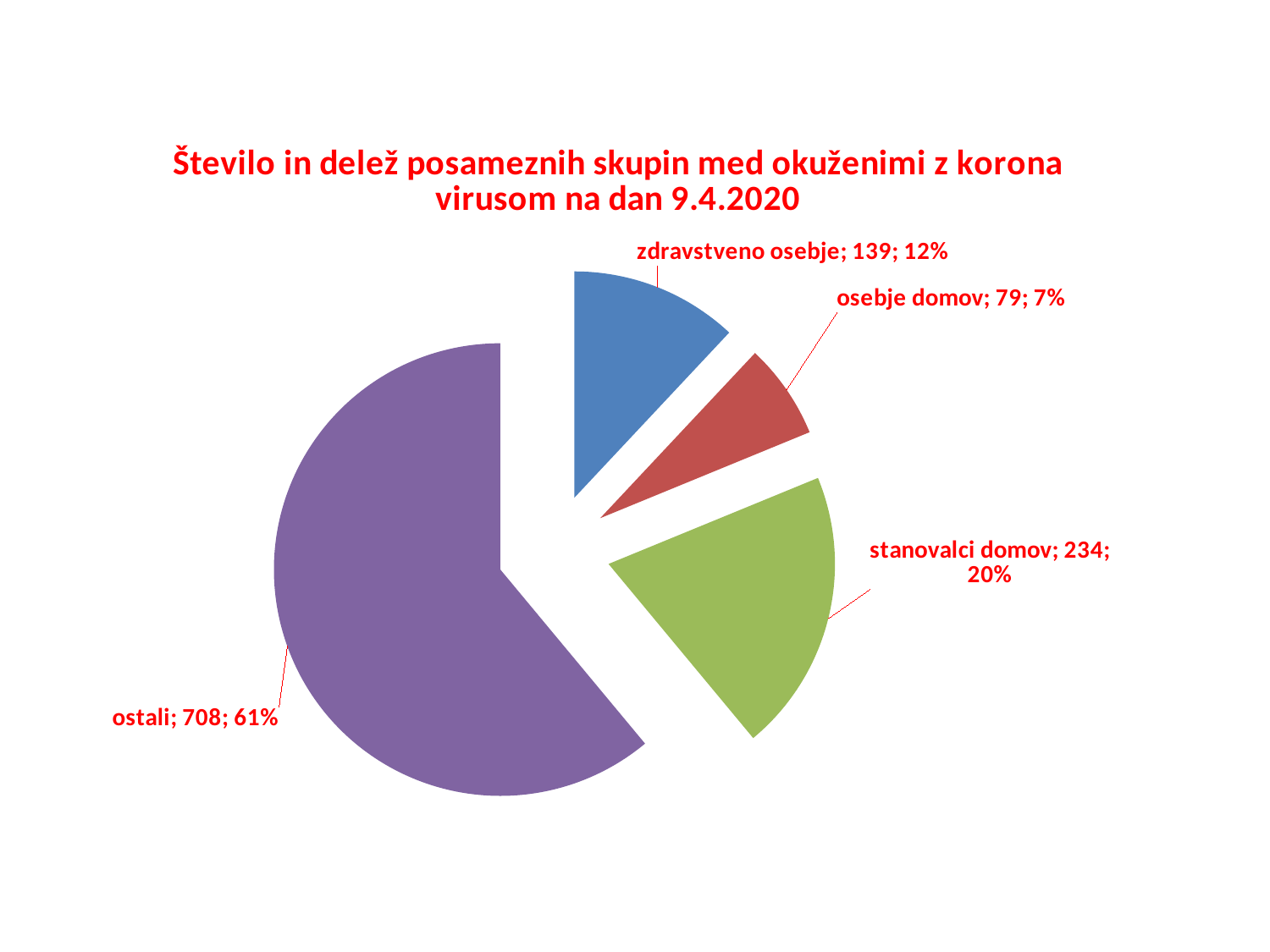
What share of the pie does the 'ostali' slice represent? 61% Which group has the largest slice of the pie? ostali Which is larger, the value for 'zdravstveno osebje' or the value for 'osebje domov'? zdravstveno osebje Which group has the smallest slice of the pie? osebje domov What kind of chart is shown on the slide? pie chart What is the difference between the number for 'stanovalci domov' and the number for 'zdravstveno osebje'? 95 What share of the pie does the 'stanovalci domov' slice represent? 20% What is the number of infected people in the 'osebje domov' group? 79 What is the number of infected people in the 'zdravstveno osebje' group? 139 How many slices does the pie chart have? 4 What is the number of infected people in the 'stanovalci domov' group? 234 What is the number of infected people in the 'ostali' group? 708